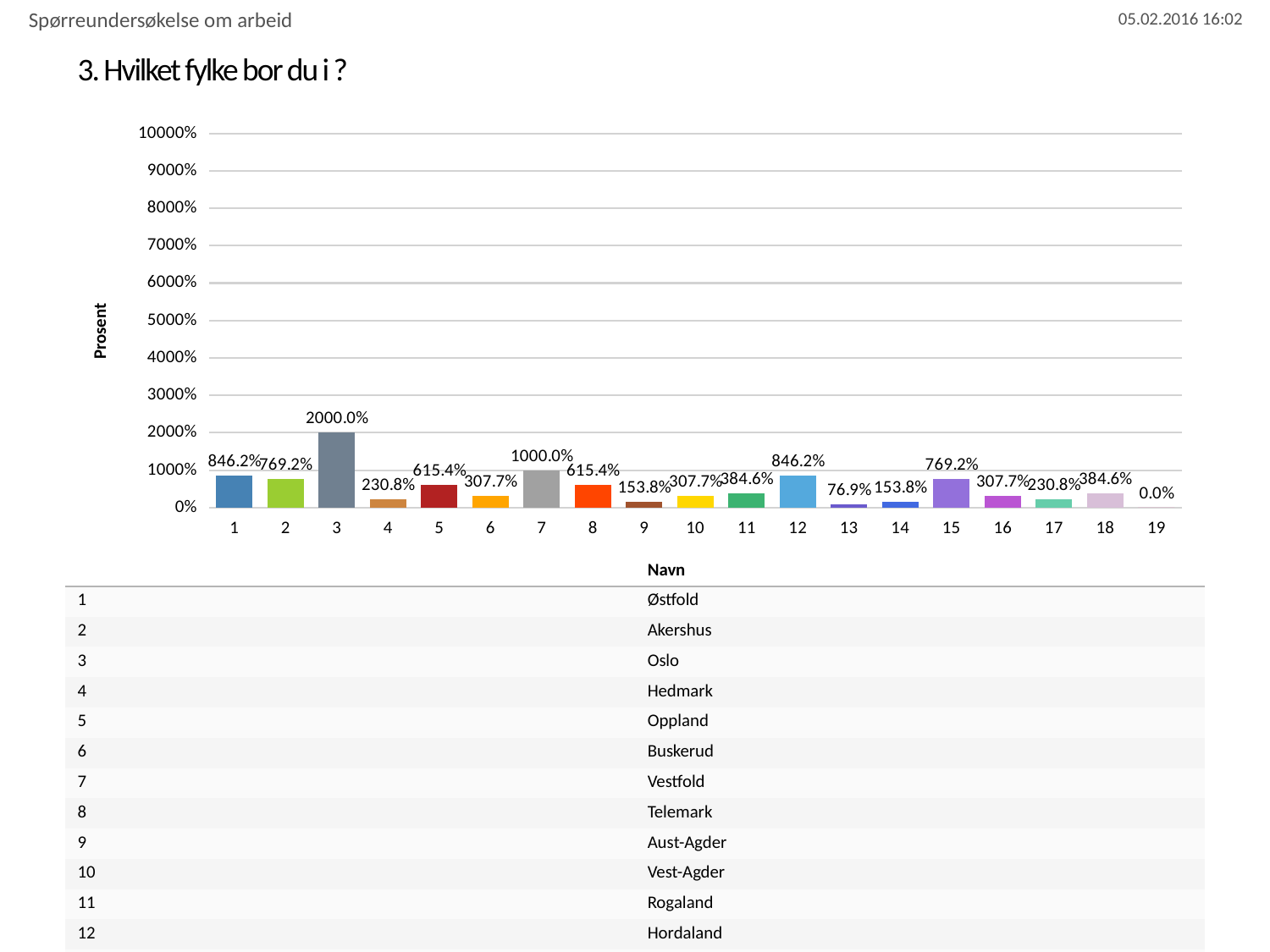
Is the value for category 3 greater or less than 1000%? greater What is the value for category 13 in the chart? 76.9% What is the difference between the values for category 1 and category 2? 77.0% Which category has the highest value in the chart? 3 Which category has the lowest value in the chart? 19 What is the value for category 19 in the chart? 0.0% Which is larger, the value for category 12 or the value for category 15? 12 What is the value for category 3 in the chart? 2000.0% How many categories are shown on the x axis of the chart? 19 What is the value for category 7 in the chart? 1000.0% What kind of chart is shown on the slide? bar chart What is the difference between the values for category 3 and category 7? 1000.0%